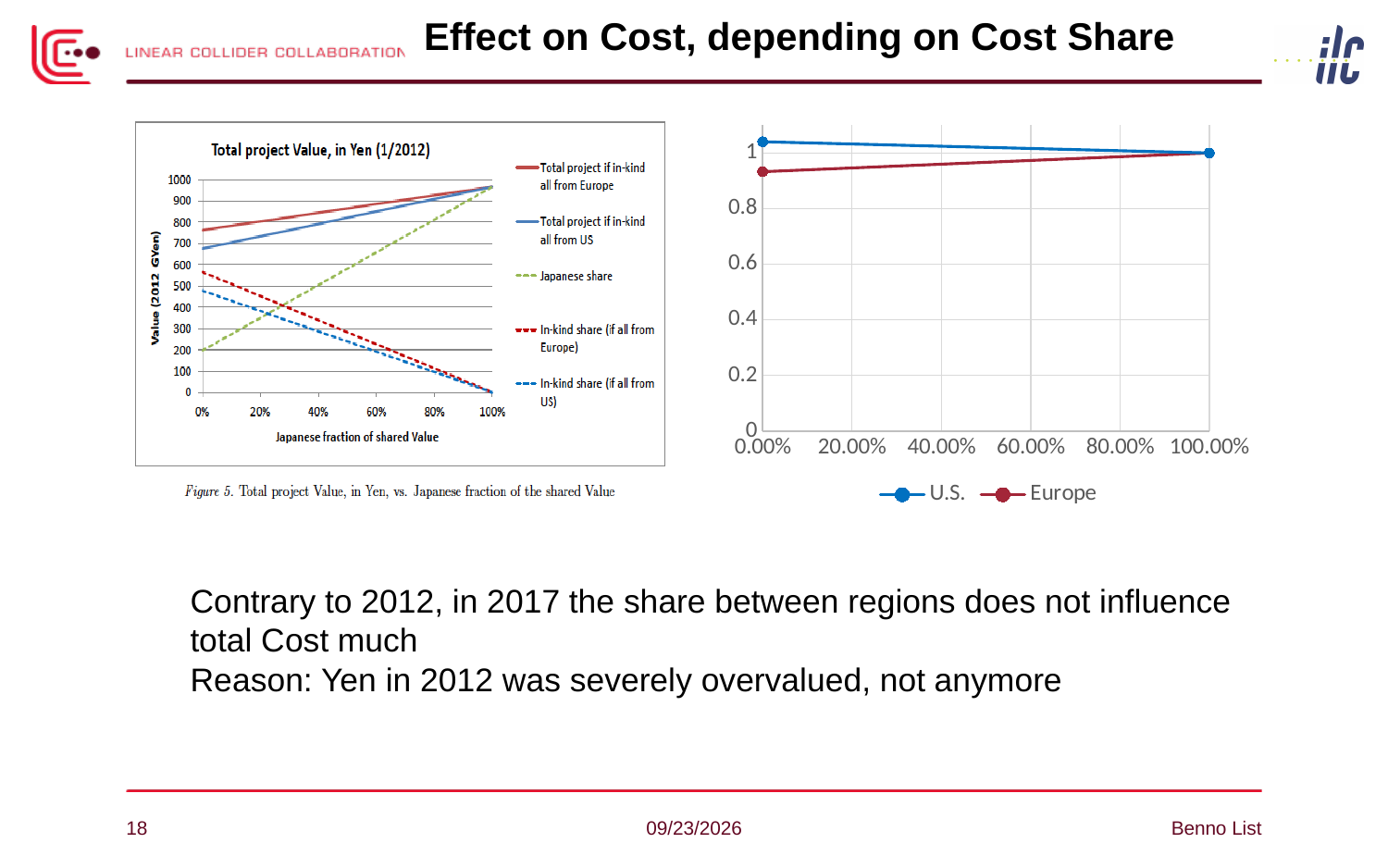
Which two series are listed in the legend of the right-hand chart? U.S. and Europe In the left-hand chart, at 0%, which is higher: Total project if in-kind all from Europe or Total project if in-kind all from US? Total project if in-kind all from Europe In the right-hand chart, does the U.S. line rise or fall from 0.00% to 100.00%? fall How many series does the legend of the right-hand chart list? 2 In the right-hand chart, does the Europe line rise or fall from 0.00% to 100.00%? rise What kind of chart is the chart on the right of the slide? line chart In the right-hand chart, at 0.00%, which series has the larger value, U.S. or Europe? U.S. In the right-hand chart, is the value for U.S. at 0.00% greater or less than 0.8? greater What is the title of the chart on the left of the slide? Total project Value, in Yen (1/2012) How many series does the legend of the left-hand chart list? 5 In the left-hand chart, does the Japanese share line rise or fall as the Japanese fraction of shared Value increases? rise In the right-hand chart, is the value for Europe at 0.00% greater or less than 1? less